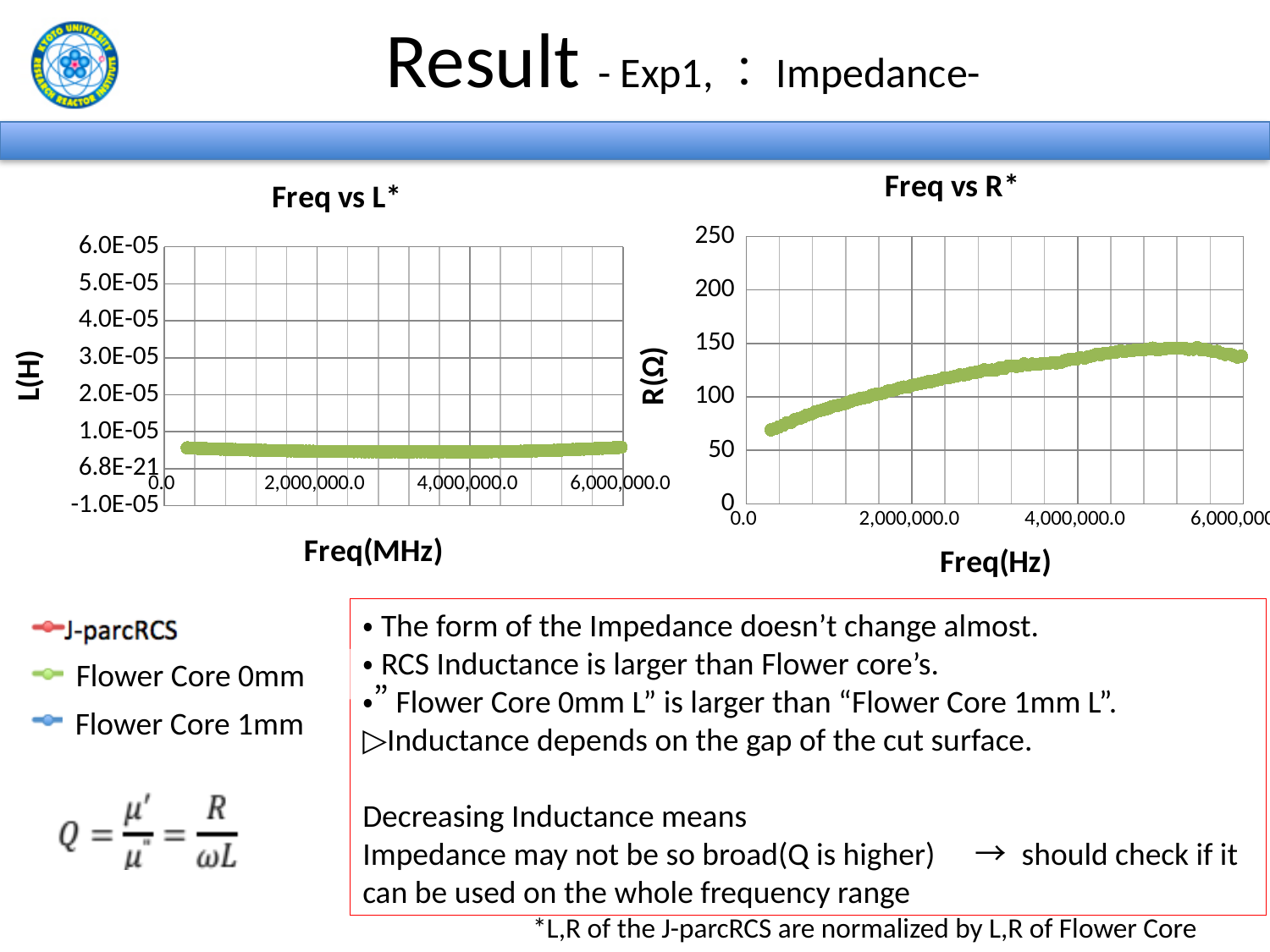
In the "Freq vs R*" chart, do the values rise or fall as frequency increases from 0.0 to 4,000,000.0 Hz? rise What kind of chart is the "Freq vs R*" chart? line chart In the "Freq vs L*" chart, are the plotted values greater or less than 1.0E-05? less How many series does the legend below the charts list? 3 In the "Freq vs R*" chart, is the value at 4,000,000.0 Hz greater or less than 100? greater What is the y-axis label of the "Freq vs R*" chart? R(Ω) In the "Freq vs R*" chart, is the value at 4,000,000.0 Hz greater or less than 150? less What is the x-axis label of the "Freq vs L*" chart? Freq(MHz)